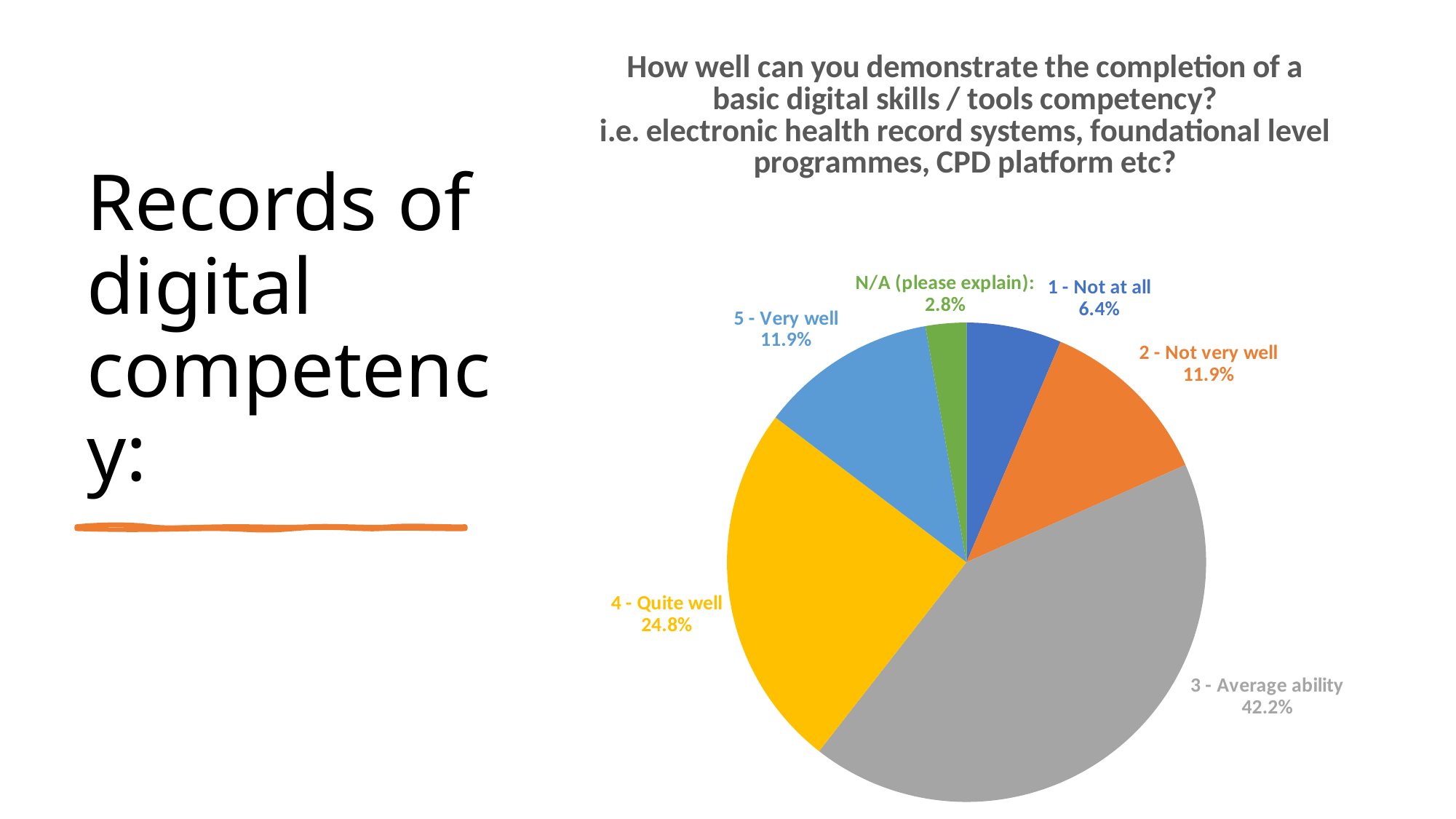
What share of the pie does "3 - Average ability" have? 42.2% Which category has the largest slice of the pie? 3 - Average ability What percentage is shown for "1 - Not at all"? 6.4% What is the difference in percentage points between "3 - Average ability" and "4 - Quite well"? 17.4 What is the difference in percentage points between "1 - Not at all" and "N/A (please explain):"? 3.6 What colour is the slice for "3 - Average ability"? Grey Which category has the smallest slice of the pie? N/A (please explain): What percentage is shown for "4 - Quite well"? 24.8% Which is larger, the slice for "4 - Quite well" or the slice for "5 - Very well"? 4 - Quite well How many slices does the pie chart have? 6 What percentage is shown for "N/A (please explain):"? 2.8% What kind of chart is shown on the slide? Pie chart